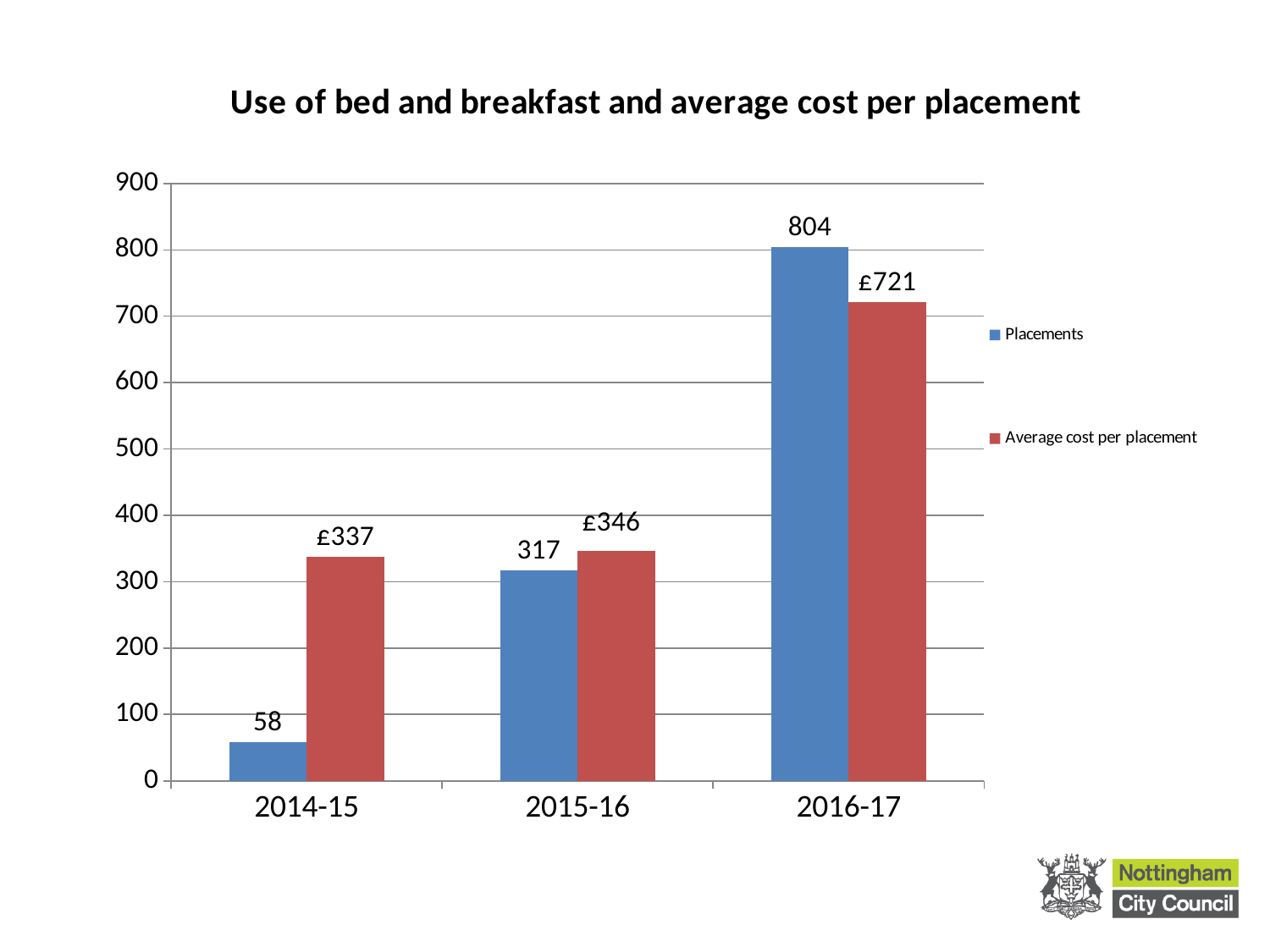
What kind of chart is shown on the slide? Bar chart How many series does the legend list? 2 What is the Average cost per placement in 2014-15? £337 What is the difference in Placements between 2016-17 and 2015-16? 487 Which is larger in 2014-15: the number of Placements or the Average cost per placement? Average cost per placement Which year has the highest number of Placements? 2016-17 What is the number of Placements in 2016-17? 804 How many years are shown on the x axis? 3 Which year has the lowest Average cost per placement? 2014-15 What is the number of Placements in 2015-16? 317 What is the difference in Average cost per placement between 2016-17 and 2015-16? £375 Do the Placements values rise or fall from 2014-15 to 2016-17? Rise